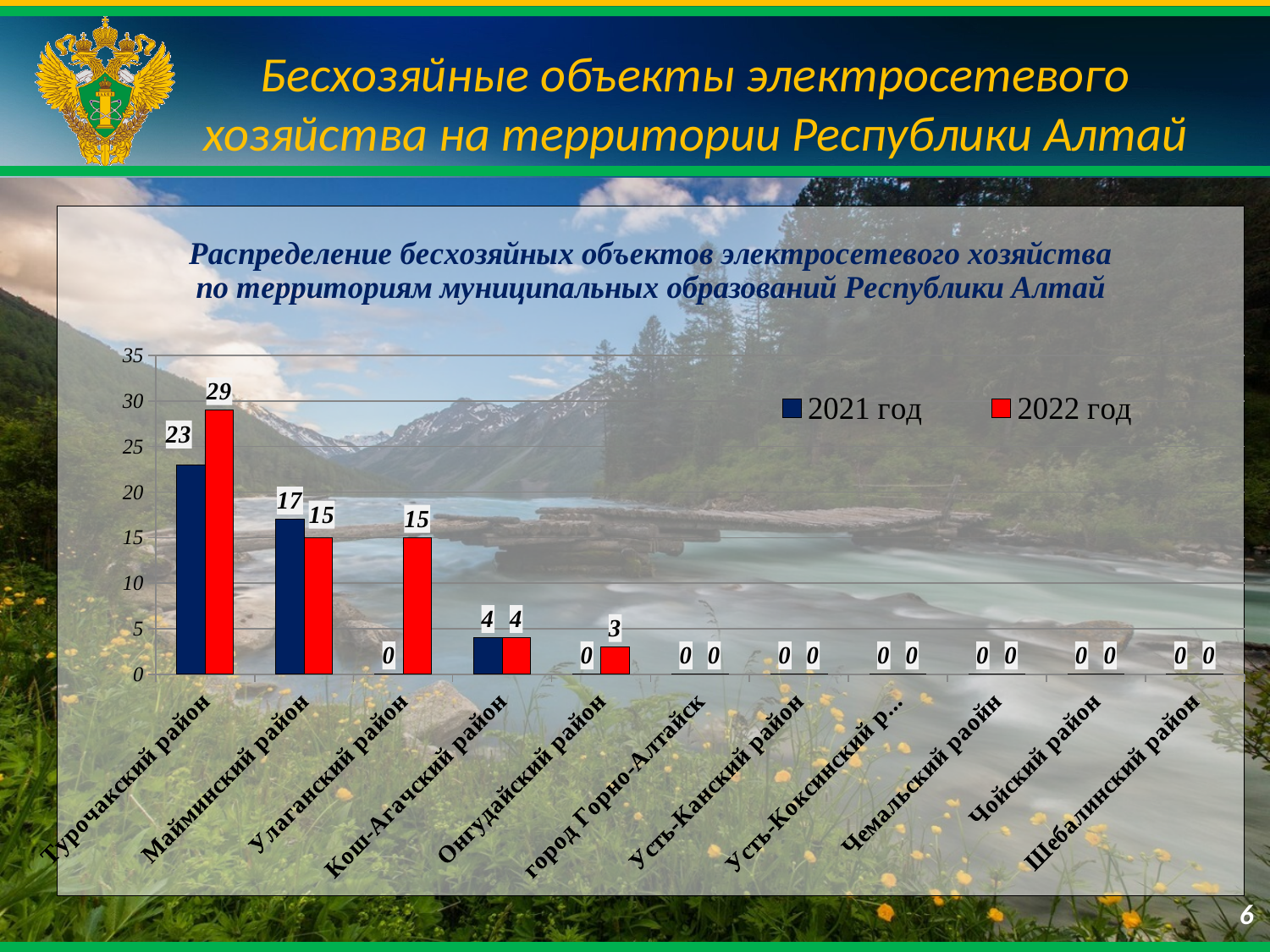
What kind of chart is shown on the slide? Bar chart How many series does the legend list? 2 What is the value for Улаганский район in the 2021 год series? 0 What is the value for Турочакский район in the 2022 год series? 29 What colour are the bars for the 2022 год series? Red What is the difference between the 2022 год and 2021 год values for Турочакский район? 6 Which category has the highest value in the 2022 год series? Турочакский район How many categories are shown on the x axis? 11 Which is larger for Майминский район: the 2021 год value or the 2022 год value? 2021 год What is the value for Онгудайский район in the 2022 год series? 3 What is the value for Майминский район in the 2021 год series? 17 What is the value for Кош-Агачский район in the 2021 год series? 4